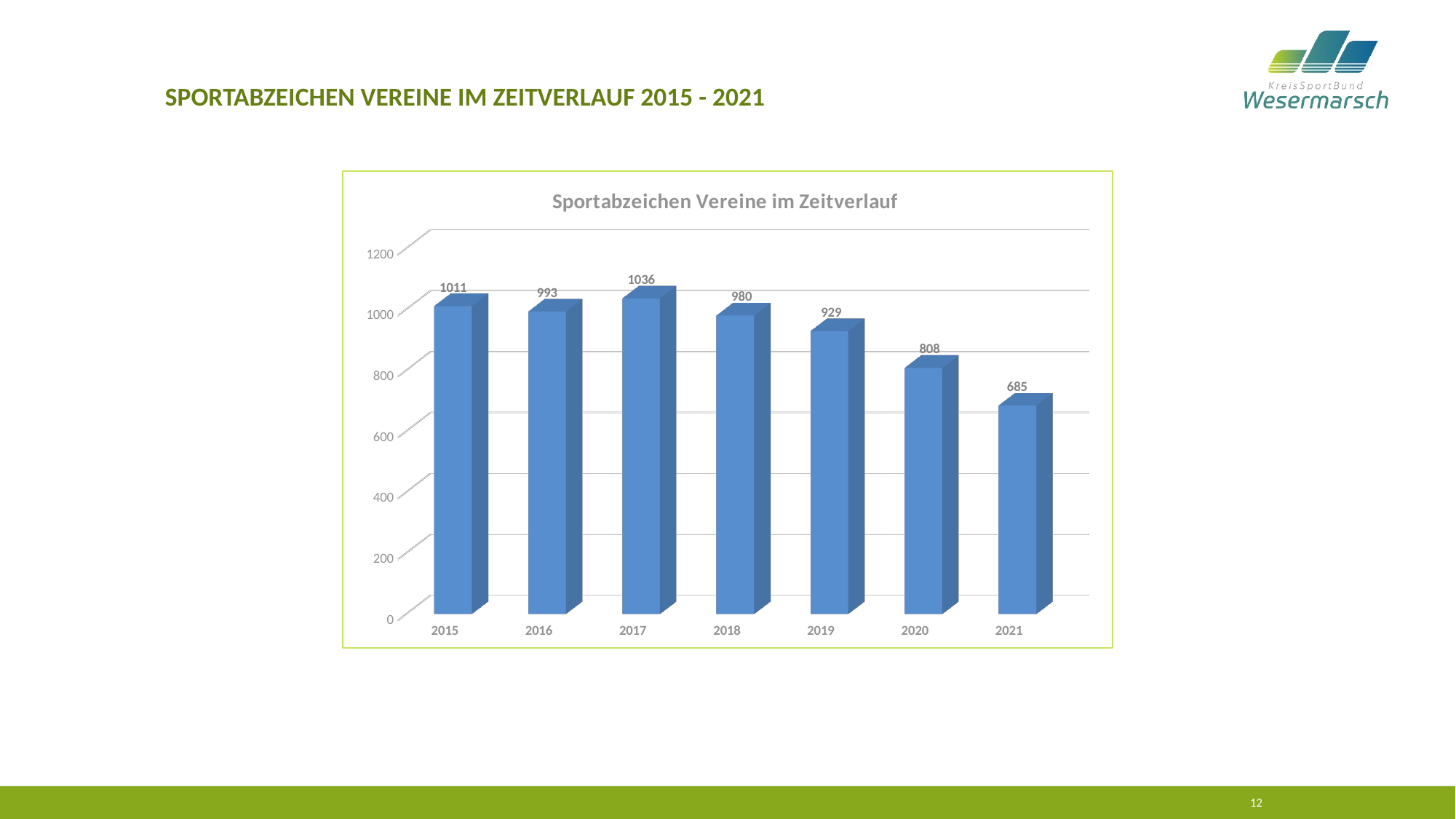
Do the values generally rise or fall from 2017 to 2021? fall Is the value for 2020 greater or less than 1000? less What is the value for 2019? 929 Which year has the highest value? 2017 What kind of chart is shown? bar chart What is the difference between the values for 2015 and 2021? 326 Which year has the lowest value? 2021 What is the value for 2021? 685 What is the difference between the values for 2019 and 2020? 121 What is the value for 2017? 1036 How many years are shown on the x axis? 7 Which is larger, the value for 2016 or the value for 2018? 2016